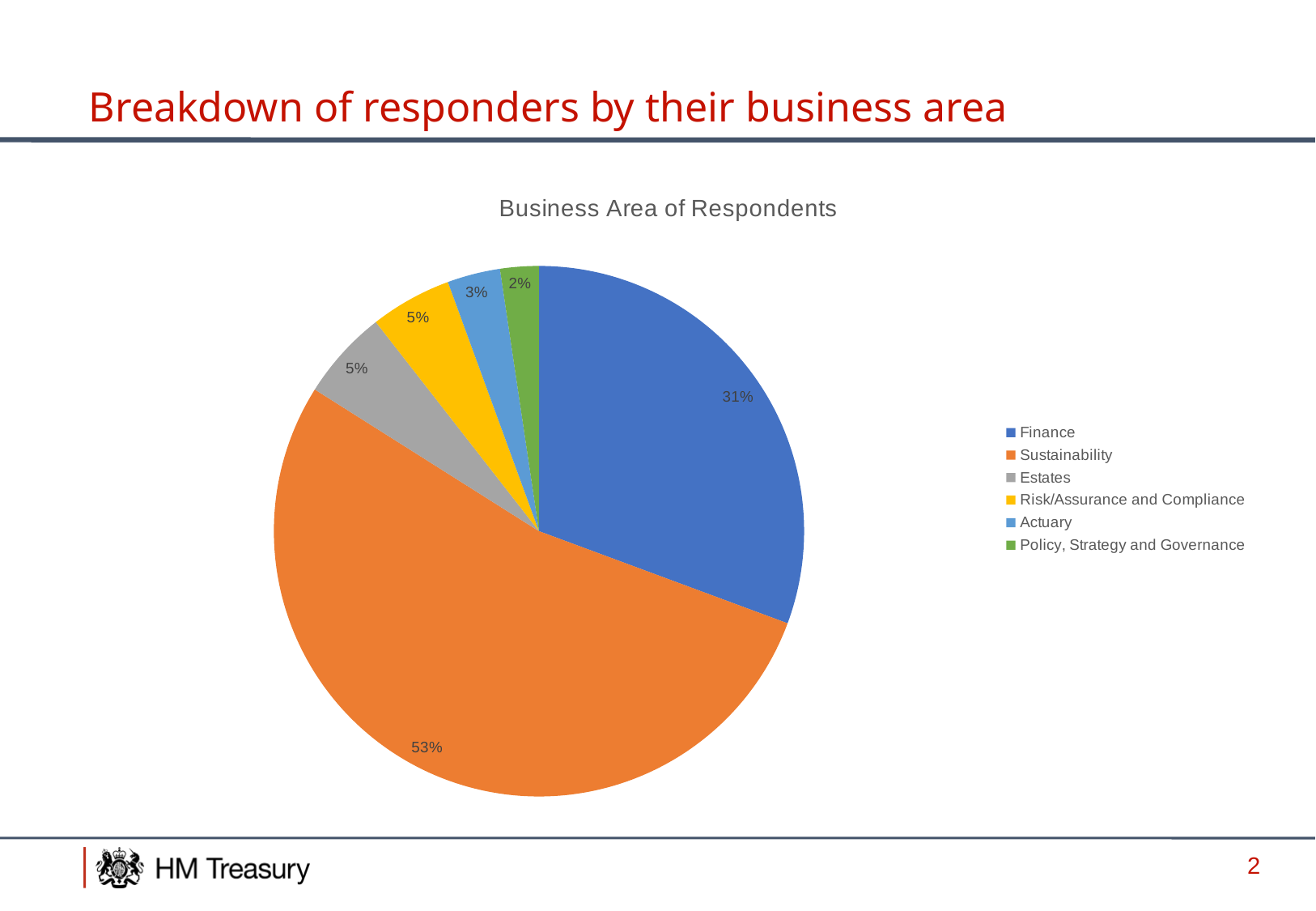
Which business area has the smallest share of respondents? Policy, Strategy and Governance Which has a larger share of respondents, Finance or Sustainability? Sustainability How many business areas are shown in the pie chart? 6 What is the difference in percentage points between the Sustainability and Finance shares? 22 Which business area has the largest share of respondents? Sustainability What share of respondents are from Finance? 31% What share of respondents are from Actuary? 3% What is the title of the chart? Business Area of Respondents What type of chart is shown on the slide? Pie chart What share of respondents are from Sustainability? 53% What share of respondents are from Estates? 5% What share of respondents are from Policy, Strategy and Governance? 2%